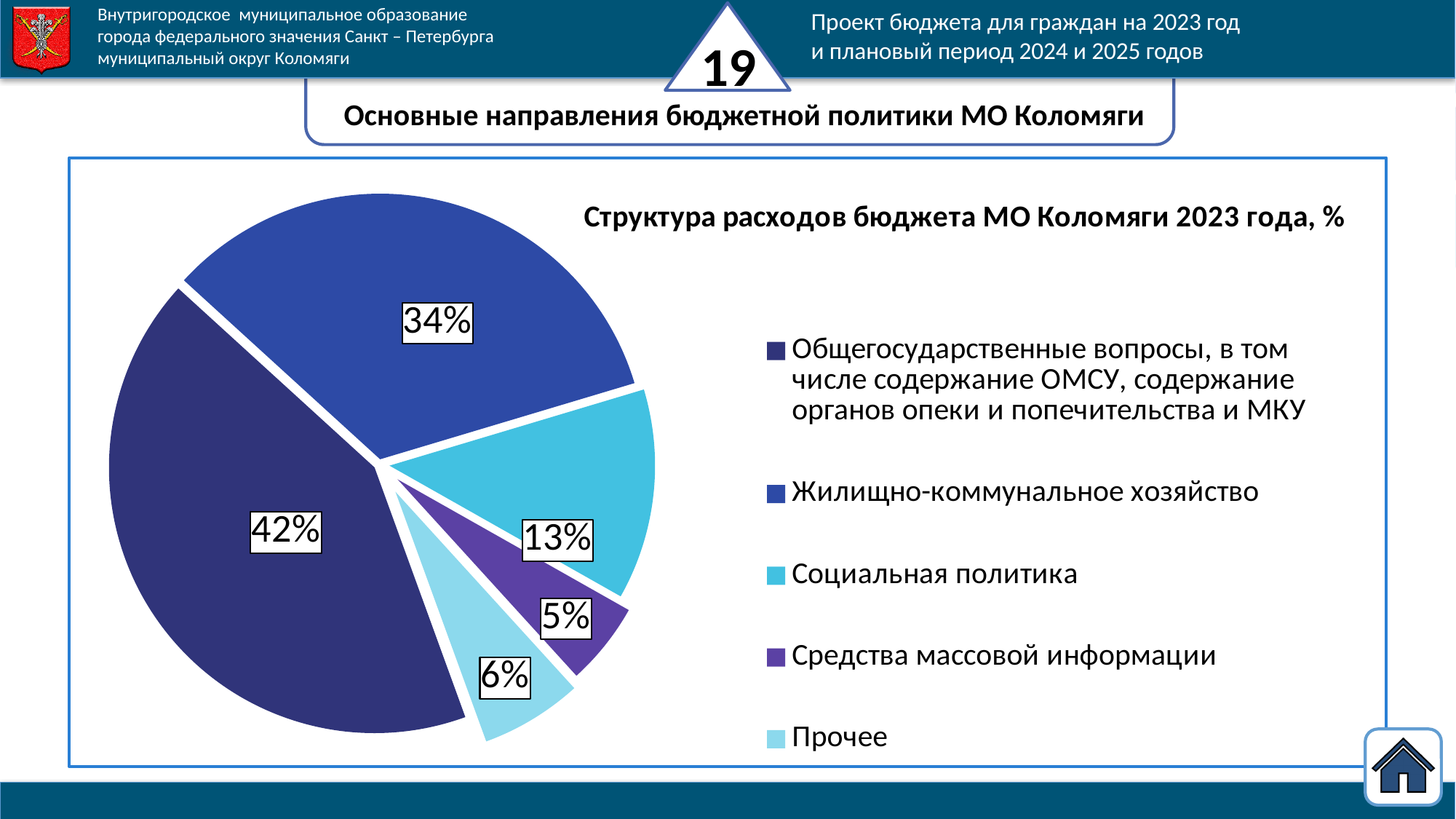
How many entries does the legend list? 5 What share of the pie is labelled for Средства массовой информации? 5% What is the title of the chart? Структура расходов бюджета МО Коломяги 2023 года, % Which category has the largest slice of the pie? Общегосударственные вопросы, в том числе содержание ОМСУ, содержание органов опеки и попечительства и МКУ What type of chart is shown on the slide? pie chart What share of the pie is labelled for Прочее? 6% What share of the pie is labelled for Социальная политика? 13% What is the difference in percentage points between the largest slice (42%) and Жилищно-коммунальное хозяйство (34%)? 8 How many slices does the pie chart have? 5 What share of the pie is labelled for Жилищно-коммунальное хозяйство? 34% Which is larger: the slice for Прочее or the slice for Средства массовой информации? Прочее Which category has the smallest slice of the pie? Средства массовой информации